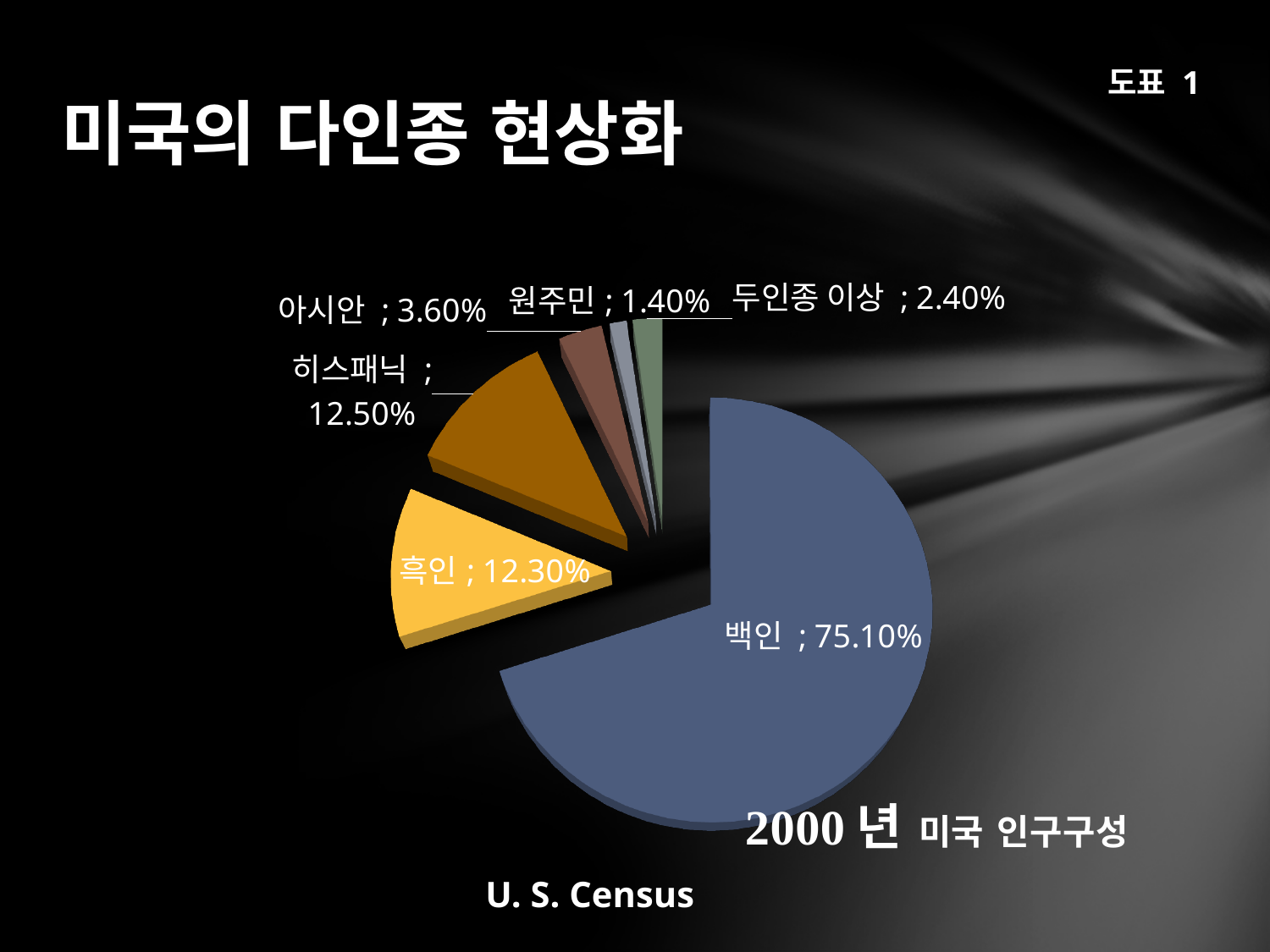
How many slices does the pie chart have? 6 Which category has the largest slice of the pie? 백인 Which category has the smallest slice of the pie? 원주민 What kind of chart is shown on the slide? Pie chart What is the difference between the 아시안 value and the 두인종 이상 value? 1.20% Which is larger, the value for 흑인 or the value for 히스패닉? 히스패닉 What source is cited below the chart? U. S. Census What is the difference between the 백인 value and the 히스패닉 value? 62.60% What is the value shown for 아시안? 3.60% What is the value shown for 히스패닉? 12.50% What is the value shown for 원주민? 1.40% What percentage does the 백인 slice represent? 75.10%